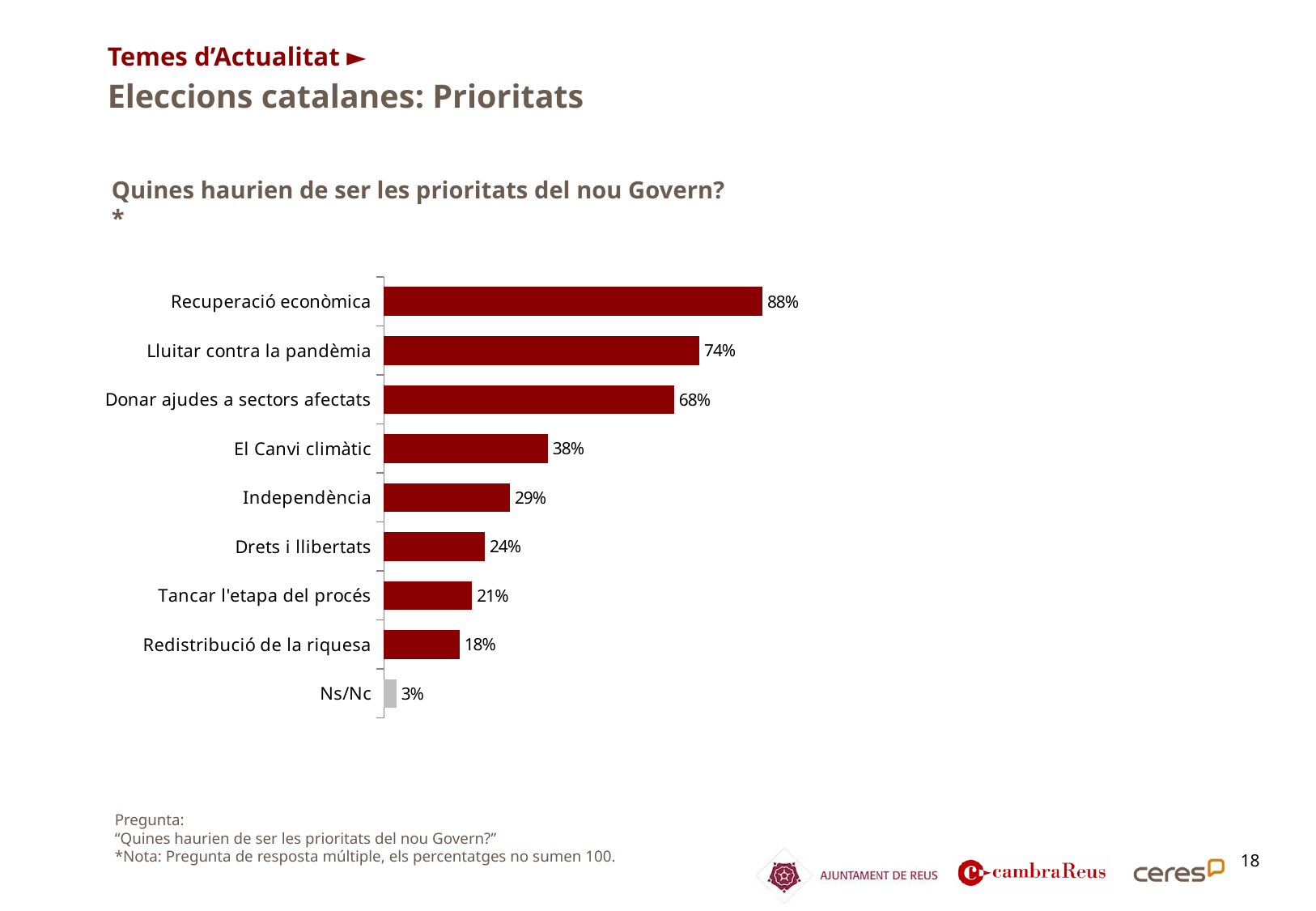
Which bar is shown in a different colour (grey) from the others? Ns/Nc What percentage of respondents chose "Recuperació econòmica" as a priority? 88% What is the difference between "Lluitar contra la pandèmia" and "Donar ajudes a sectors afectats"? 6% Which category has the highest value? Recuperació econòmica What is the difference between "Recuperació econòmica" and "Redistribució de la riquesa"? 70% What kind of chart is shown on the slide? Bar chart What is the value for "Ns/Nc"? 3% Which is larger, "Drets i llibertats" or "Tancar l'etapa del procés"? Drets i llibertats What percentage is shown for "Independència"? 29% What is the value shown for "El Canvi climàtic"? 38% Which category has the lowest value? Ns/Nc How many categories are shown in the chart? 9